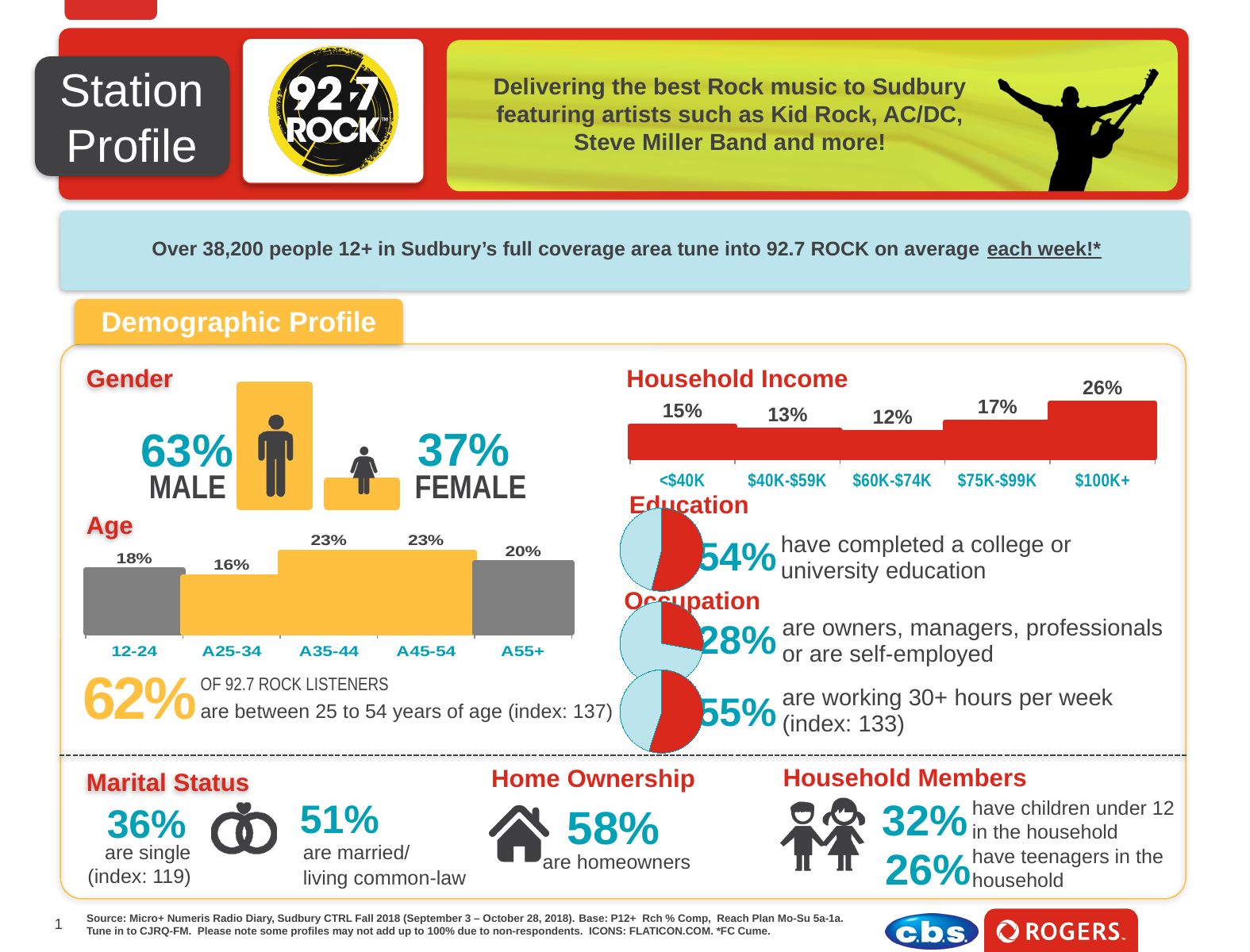
In the Age chart, is the value for 12-24 larger or smaller than the value for A25-34? larger In the Household Income chart, which income bracket has the lowest value? $60K-$74K In the Age chart, what is the value for A55+? 20% How many income brackets are shown in the Household Income chart? 5 In the Household Income chart, what is the difference between the $100K+ value and the <$40K value? 11% In the Age chart, what is the difference between the A35-44 value and the 12-24 value? 5% What kind of chart is used for the Household Income section? bar chart In the Age chart, which age group has the lowest value? A25-34 In the Gender chart, what is the difference between the MALE and FEMALE values? 26% In the Household Income chart, what is the value for $100K+? 26% In the Household Income chart, which income bracket has the highest value? $100K+ In the Gender chart, what is the value for MALE? 63%